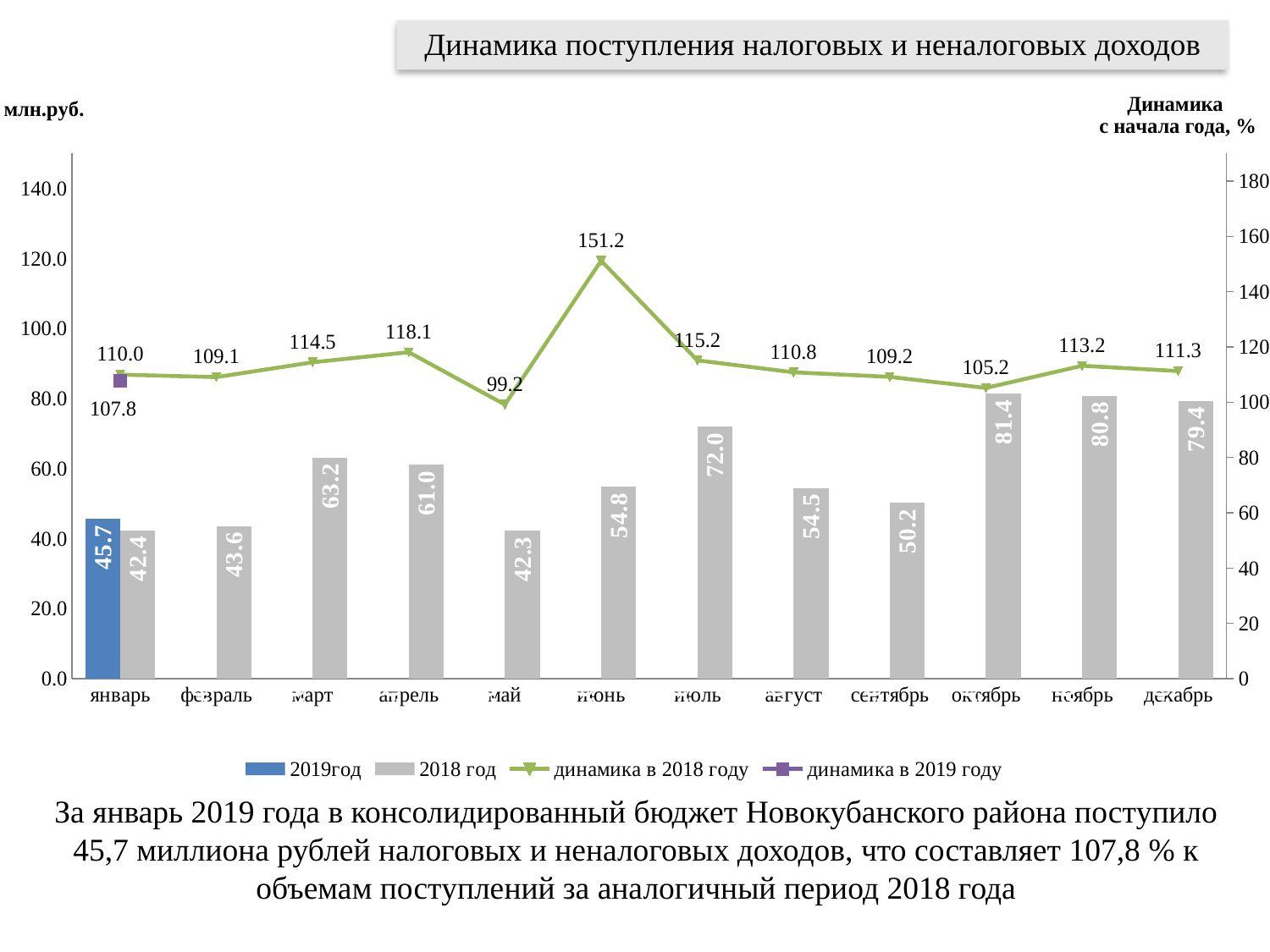
How many months are shown on the x axis? 12 What is the difference between the 2019год and 2018 год values in январь? 3.3 How many series does the legend list? 4 In which month is the динамика в 2018 году line lowest? май What is the value of динамика в 2018 году in июнь? 151.2 What is the value of динамика в 2019 году in январь? 107.8 In which month is the 2018 год bar highest? октябрь Which is larger, the 2018 год value in март or in апрель? март What is the value for 2019год in январь? 45.7 Does the динамика в 2018 году line rise or fall from июнь to октябрь? fall What kind of chart is this? Combined bar and line chart What is the value for 2018 год in октябрь? 81.4